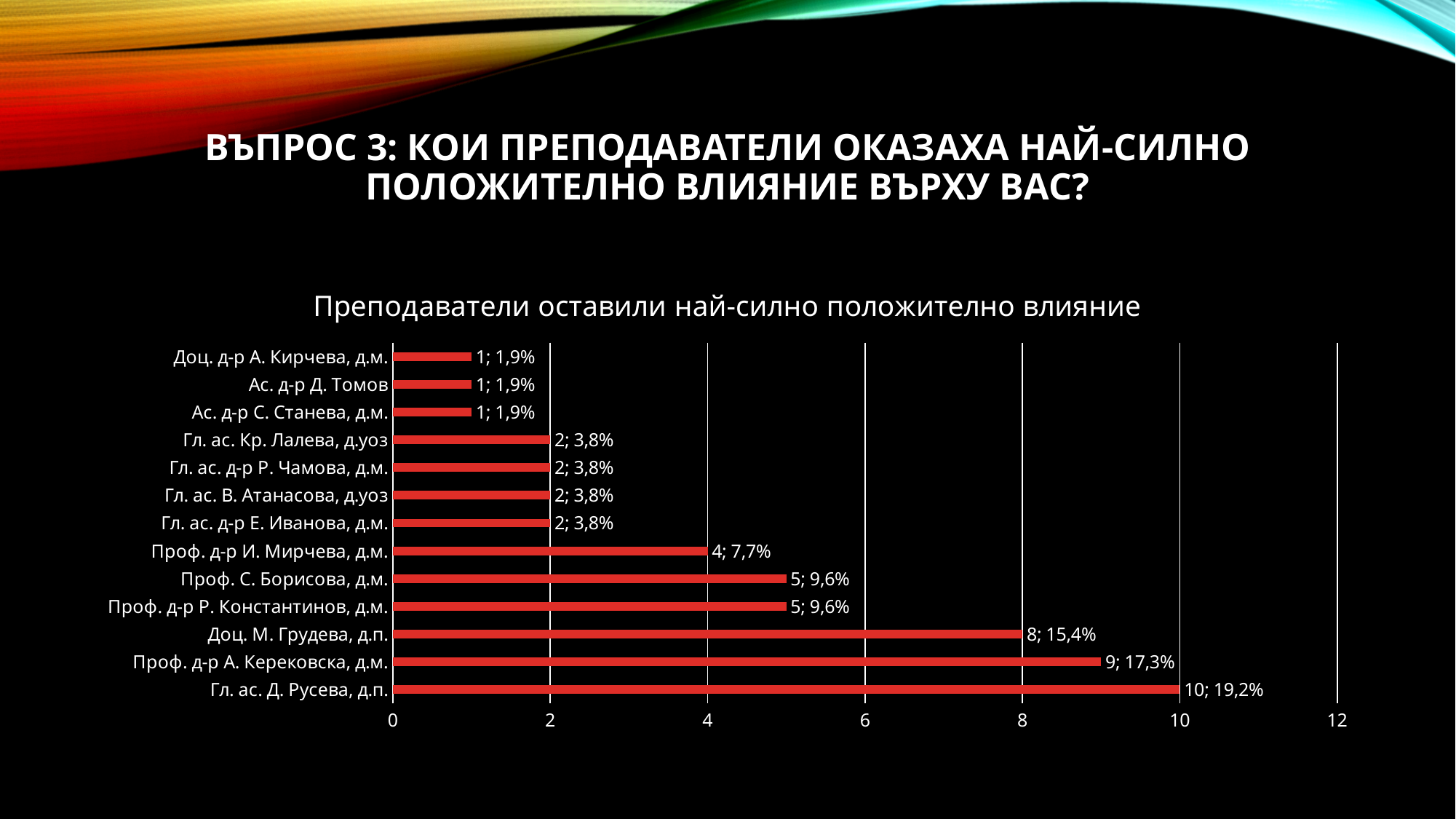
What percentage is shown for Проф. д-р А. Керековска, д.м.? 17,3% What kind of chart is shown? Bar chart What is the value for Гл. ас. Д. Русева, д.п.? 10; 19,2% What is the difference in count between Гл. ас. Д. Русева, д.п. and Доц. М. Грудева, д.п.? 2 How many lecturers have a value of 2; 3,8%? 4 What is the value for Доц. М. Грудева, д.п.? 8; 15,4% Which has a larger value: Проф. С. Борисова, д.м. or Проф. д-р И. Мирчева, д.м.? Проф. С. Борисова, д.м. What is the title of the chart? Преподаватели оставили най-силно положително влияние Which lecturer has the highest value? Гл. ас. Д. Русева, д.п. Is the value for Проф. д-р А. Керековска, д.м. greater or less than 8? greater What is the value for Проф. д-р И. Мирчева, д.м.? 4; 7,7% How many lecturers are listed in the chart? 13